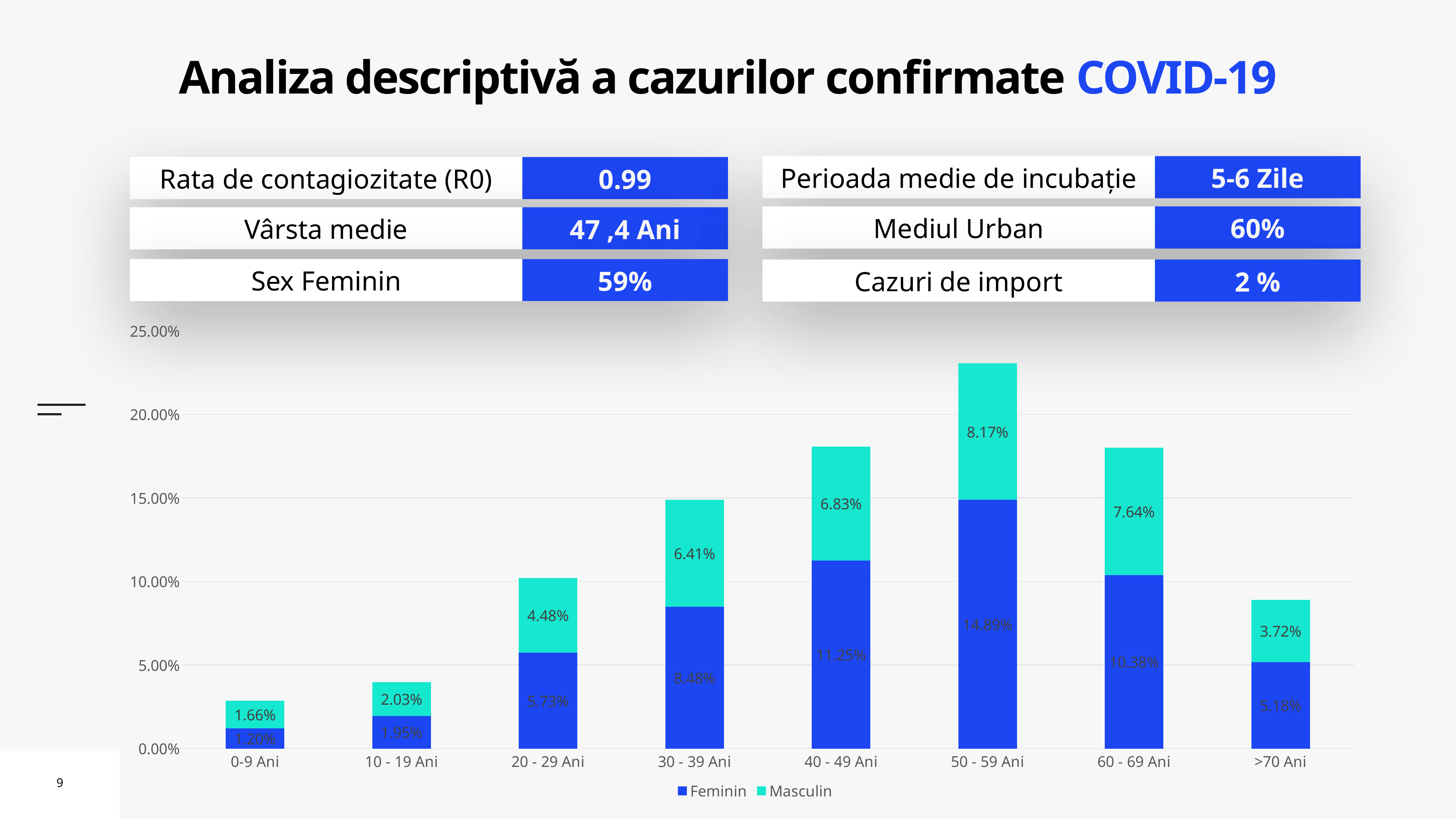
Which age group has the highest Feminin value? 50 - 59 Ani What is the difference between the Feminin and Masculin values for the 40 - 49 Ani age group? 4.42% How many age groups are shown on the x axis of the chart? 8 What is the Masculin value for the 30 - 39 Ani age group? 6.41% What is the total of the stacked bar for the 50 - 59 Ani age group? 23.06% Which age group has the lowest Masculin value? 0-9 Ani Which is larger for the 20 - 29 Ani age group, the Feminin value or the Masculin value? Feminin How many series does the chart legend list? 2 What is the Feminin value for the 50 - 59 Ani age group? 14.89% What type of chart is shown on the slide? Stacked bar chart Which colour represents the Masculin series in the chart? Turquoise (light cyan) What is the Feminin value for the >70 Ani age group? 5.18%